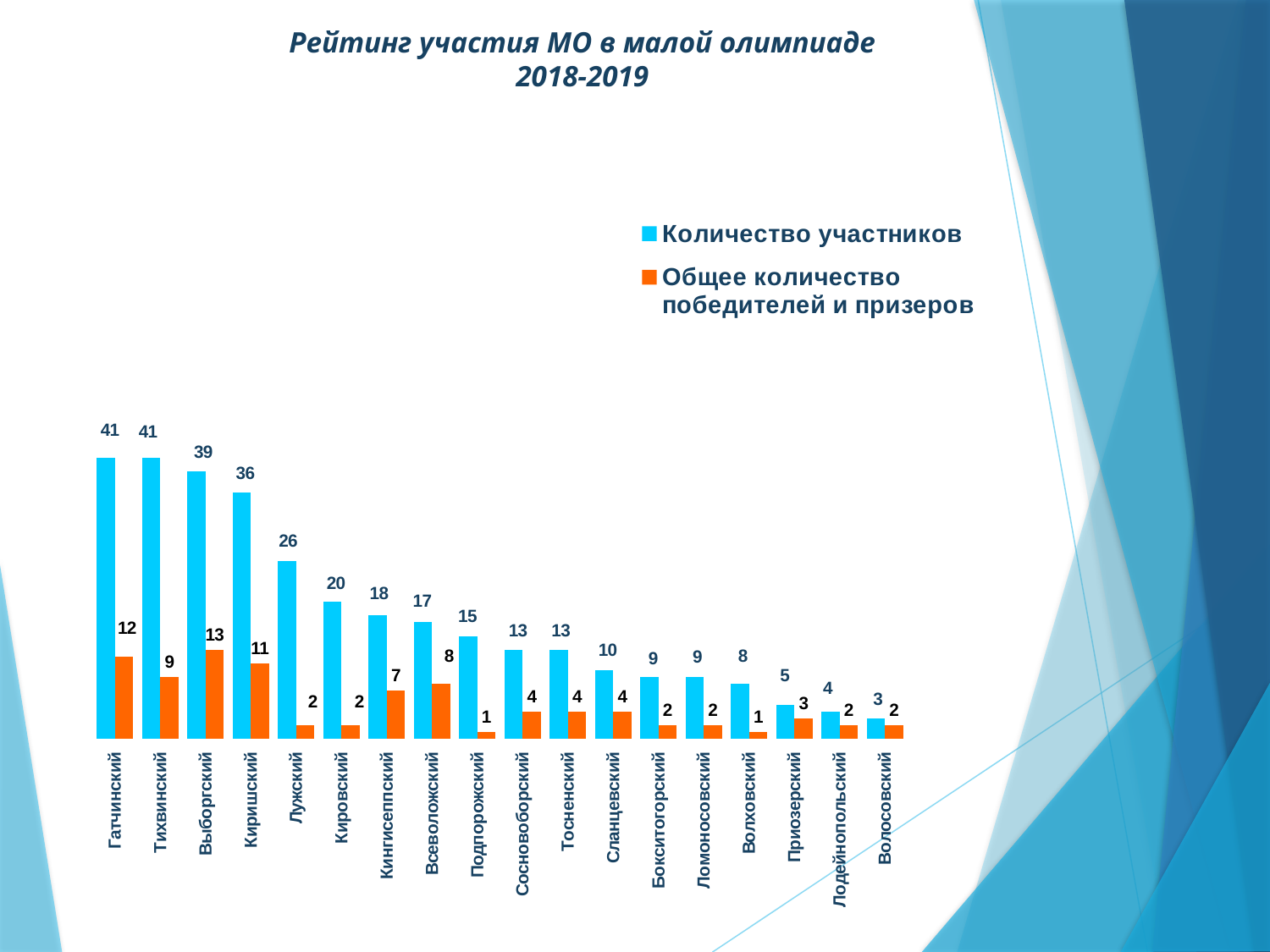
What is the difference between 'Количество участников' and 'Общее количество победителей и призеров' for Гатчинский? 29 What is the value of 'Общее количество победителей и призеров' for Кингисеппский? 7 Which is larger: 'Количество участников' for Кировский or for Всеволожский? Кировский How many districts (categories) are shown on the x axis? 18 How many series does the legend list? 2 What is the value of 'Количество участников' for Выборгский? 39 What kind of chart is shown on the slide? bar chart Do the values of 'Количество участников' rise or fall from left to right along the x axis? fall Which district has the highest value for 'Общее количество победителей и призеров'? Выборгский Which district has the lowest value for 'Количество участников'? Волосовский What is the value of 'Количество участников' for Лужский? 26 What is the title of the chart? Рейтинг участия МО в малой олимпиаде 2018-2019